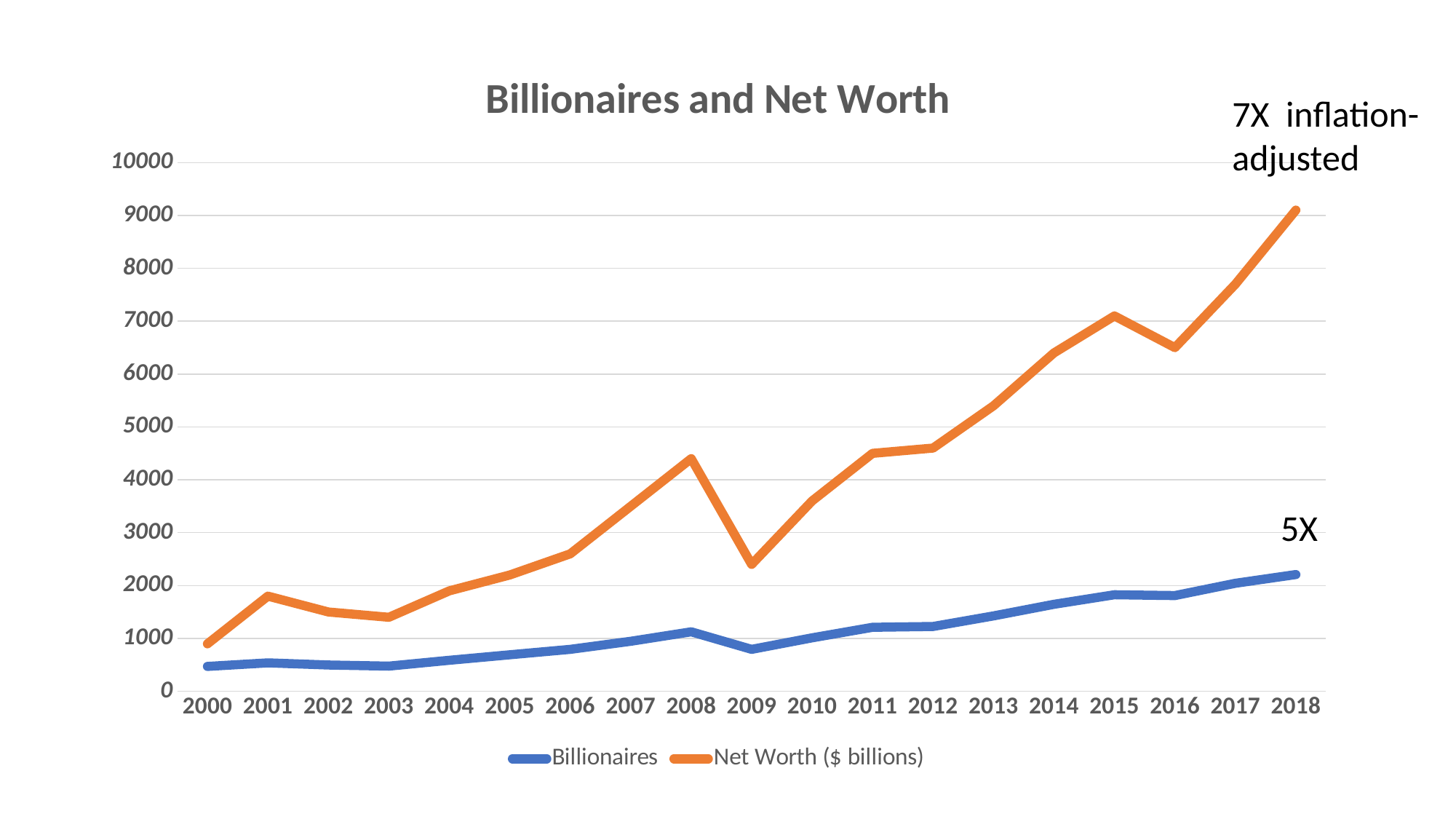
Which year has the highest value for Net Worth ($ billions)? 2018 How many series does the legend list? 2 What is the title of the chart? Billionaires and Net Worth Which is larger, the Net Worth ($ billions) value in 2015 or in 2016? 2015 What kind of chart is shown on the slide? line chart Is the value for Net Worth ($ billions) in 2018 greater or less than 8000? greater How many years are plotted along the x axis? 19 Is the value for Billionaires in 2018 greater or less than 2000? greater What annotation is written next to the end of the Billionaires line? 5X Is the value for Net Worth ($ billions) in 2009 greater or less than 3000? less Which year has the lowest value for Net Worth ($ billions)? 2000 Does the Net Worth ($ billions) line generally rise or fall from 2000 to 2018? rise